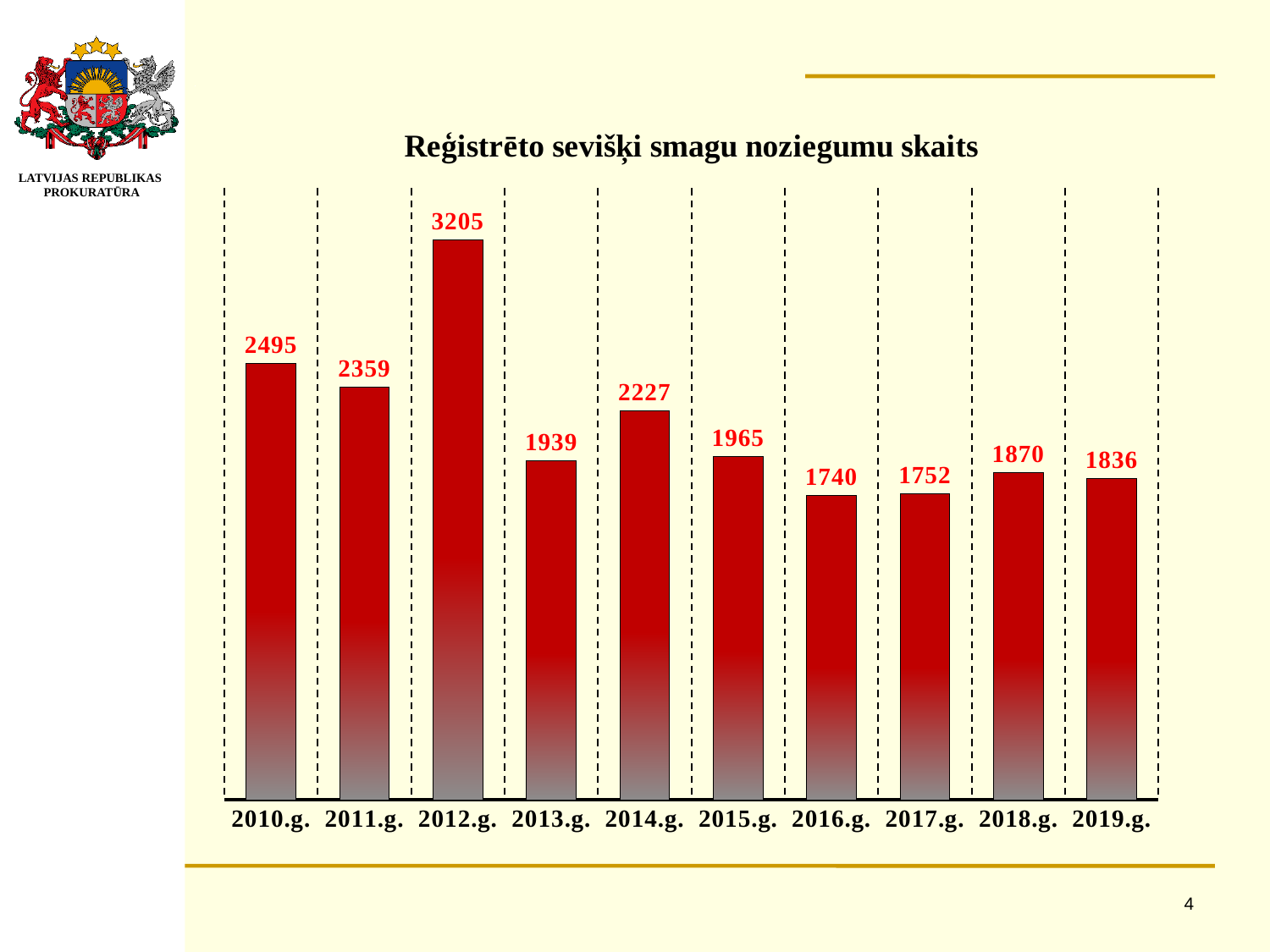
Which is larger, the value for 2014.g. or the value for 2015.g.? 2014.g. Which year has the lowest value? 2016.g. What is the value for 2019.g.? 1836 Which year has the highest value? 2012.g. What is the title of the chart? Reģistrēto sevišķi smagu noziegumu skaits What is the difference between the values for 2010.g. and 2011.g.? 136 How many years are shown on the x axis? 10 What kind of chart is shown on the slide? bar chart Do the values rise or fall from 2010.g. to 2011.g.? fall What is the difference between the values for 2012.g. and 2013.g.? 1266 What is the value for 2012.g.? 3205 What is the value for 2016.g.? 1740